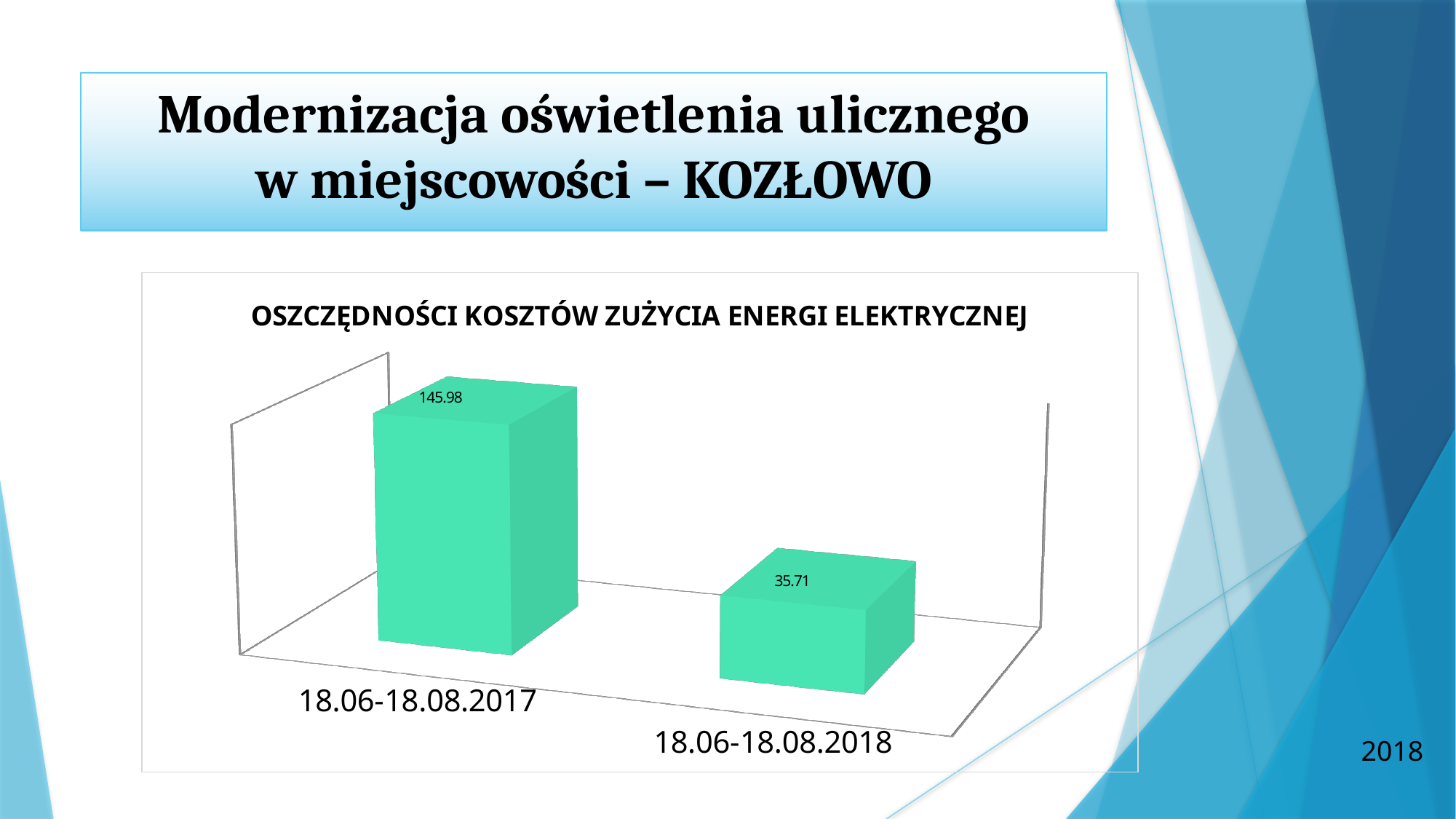
How many categories are shown in the chart? 2 What is the value for 18.06-18.08.2018? 35.71 What is the value for 18.06-18.08.2017? 145.98 What is the title of the chart? OSZCZĘDNOŚCI KOSZTÓW ZUŻYCIA ENERGI ELEKTRYCZNEJ Do the values rise or fall from 18.06-18.08.2017 to 18.06-18.08.2018? fall Which category has the highest value? 18.06-18.08.2017 What kind of chart is shown on the slide? bar chart What is the difference between the values for 18.06-18.08.2017 and 18.06-18.08.2018? 110.27 What colour are the bars in the chart? green Which is larger, the value for 18.06-18.08.2017 or for 18.06-18.08.2018? 18.06-18.08.2017 Which category has the lowest value? 18.06-18.08.2018